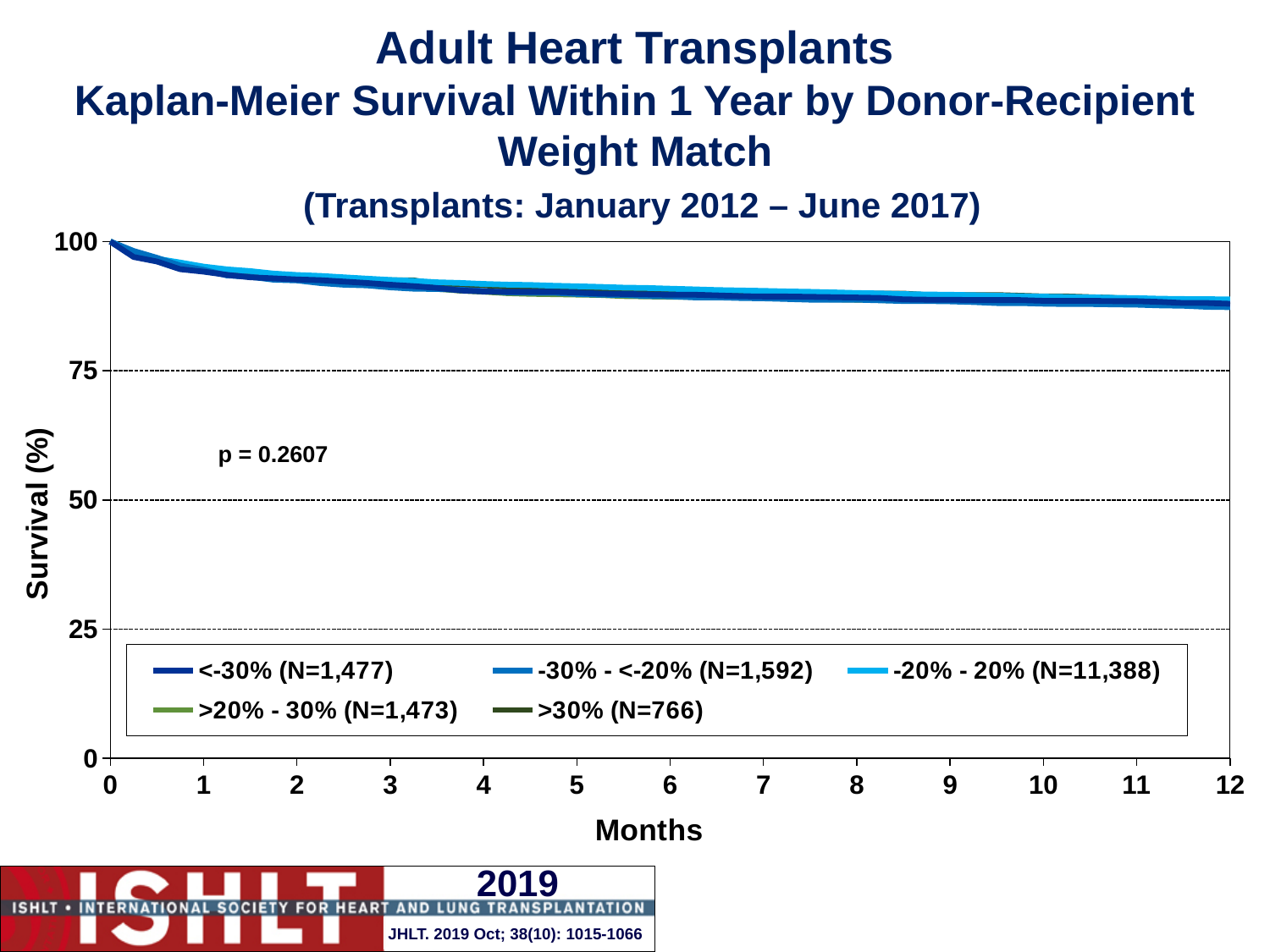
How many series does the legend list? 5 Is the survival value for the >20% - 30% group at 1 month greater or less than 75? greater Is the survival value for the <-30% group at 6 months greater or less than 75? greater Is the survival value for the >30% group at 12 months greater or less than 50? greater What kind of chart is shown on the slide? line chart Which legend group has the largest N? -20% - 20% (N=11,388) Do the survival curves rise or fall as months increase along the x axis? fall What is the p-value printed on the chart? p = 0.2607